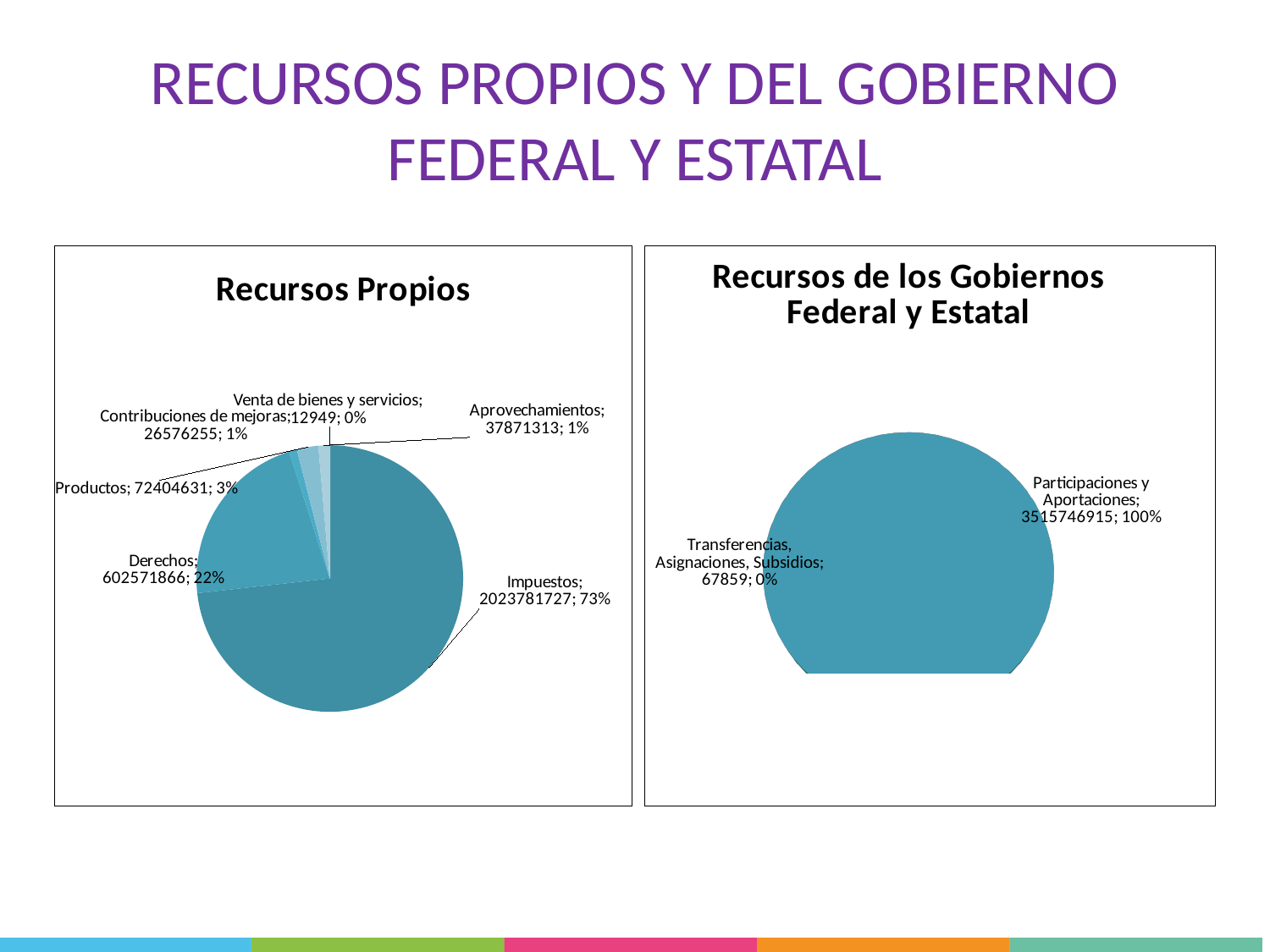
In the 'Recursos Propios' chart, how many categories are shown? 6 In the 'Recursos de los Gobiernos Federal y Estatal' chart, what value is shown for Participaciones y Aportaciones? 3515746915 In the 'Recursos Propios' chart, what is the difference between the values for Impuestos and Derechos? 1421209861 In the 'Recursos Propios' chart, what value is shown for Impuestos? 2023781727 In the 'Recursos Propios' chart, which category has the largest slice? Impuestos In the 'Recursos Propios' chart, what share of the pie does Productos represent? 3% In the 'Recursos de los Gobiernos Federal y Estatal' chart, how many categories are shown? 2 In the 'Recursos Propios' chart, which is larger: Aprovechamientos or Contribuciones de mejoras? Aprovechamientos In the 'Recursos de los Gobiernos Federal y Estatal' chart, what share is shown for Transferencias, Asignaciones, Subsidios? 0% In the 'Recursos Propios' chart, which category has the smallest value? Venta de bienes y servicios In the 'Recursos Propios' chart, what value is shown for Derechos? 602571866 What kind of chart is 'Recursos de los Gobiernos Federal y Estatal'? Pie chart